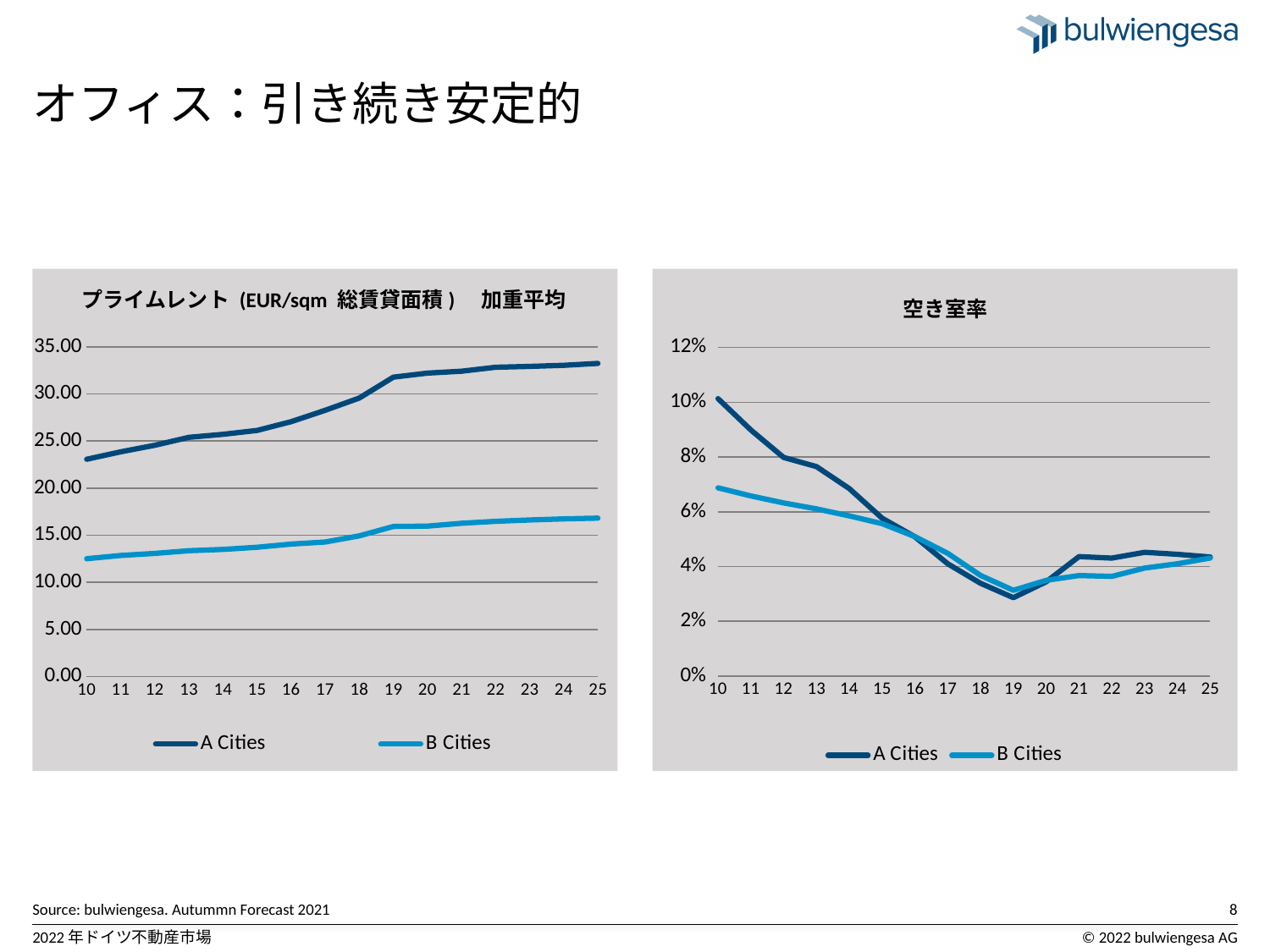
In the left chart (プライムレント), is the value for B Cities in year 10 greater or less than 15.00? less In the left chart (プライムレント), is the value for A Cities in year 25 greater or less than 30.00? greater In the right chart (空き室率), is the value for A Cities in year 19 greater or less than 4%? less What kind of chart is the left chart (プライムレント)? line chart In the left chart (プライムレント), do the values for A Cities rise or fall from year 10 to year 25? rise In the right chart (空き室率), in which year does the A Cities series reach its lowest value? 19 How many series does the legend of the right chart (空き室率) list? 2 How many years are plotted along the x axis of the left chart (プライムレント)? 16 In the right chart (空き室率), which series is higher in year 10, A Cities or B Cities? A Cities In the left chart (プライムレント), which series is higher in year 25, A Cities or B Cities? A Cities What is the title of the right chart? 空き室率